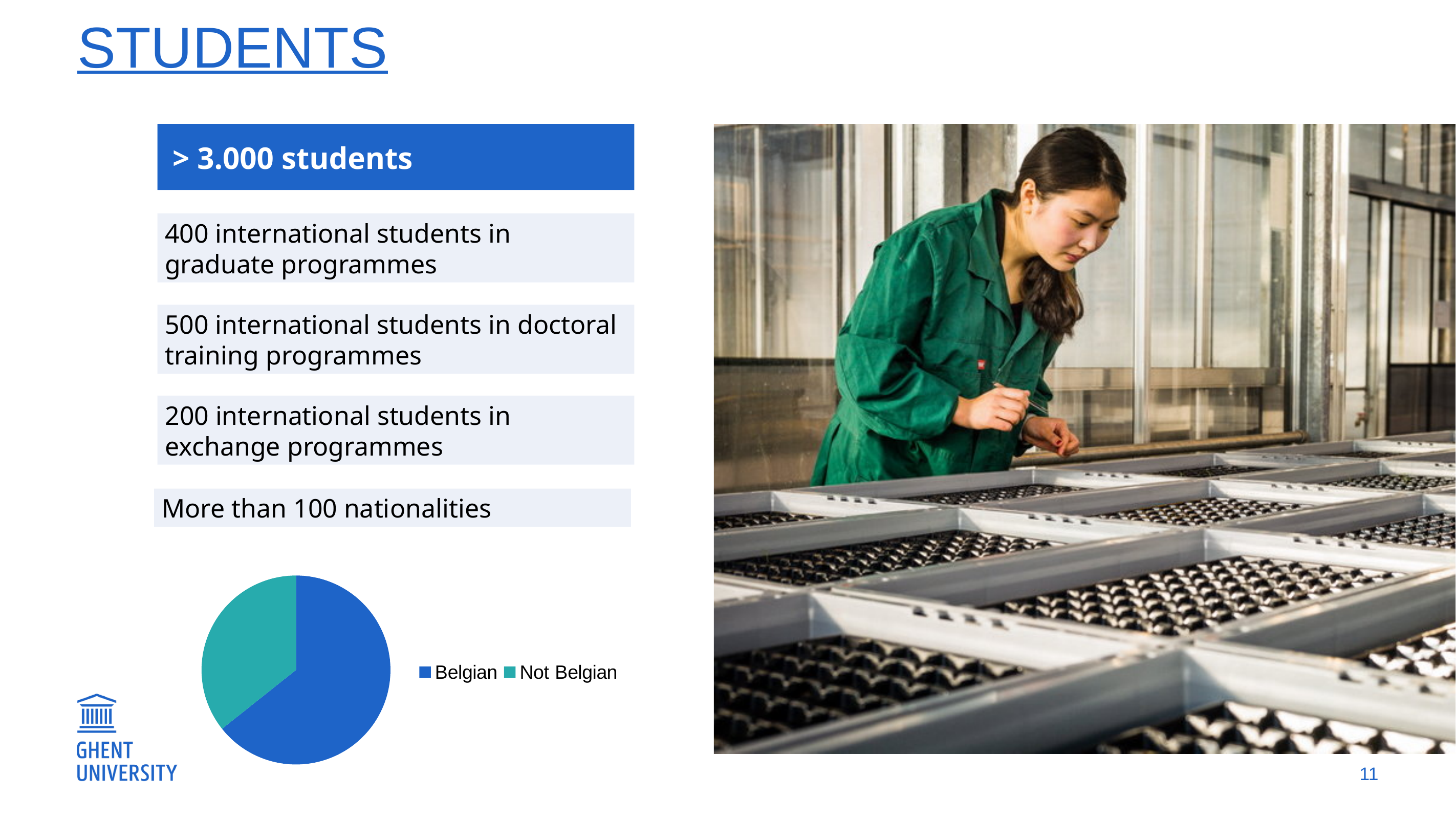
How many slices does the pie chart have? 2 Does the Belgian slice make up more or less than half of the pie chart? more Which category has the largest slice in the pie chart? Belgian Which category has the smallest slice in the pie chart? Not Belgian What are the two categories listed in the pie chart's legend? Belgian, Not Belgian How many entries does the pie chart's legend list? 2 What kind of chart is shown at the bottom left of the slide? pie chart In the pie chart, which slice is larger: Belgian or Not Belgian? Belgian What colour is the Belgian slice in the pie chart? blue